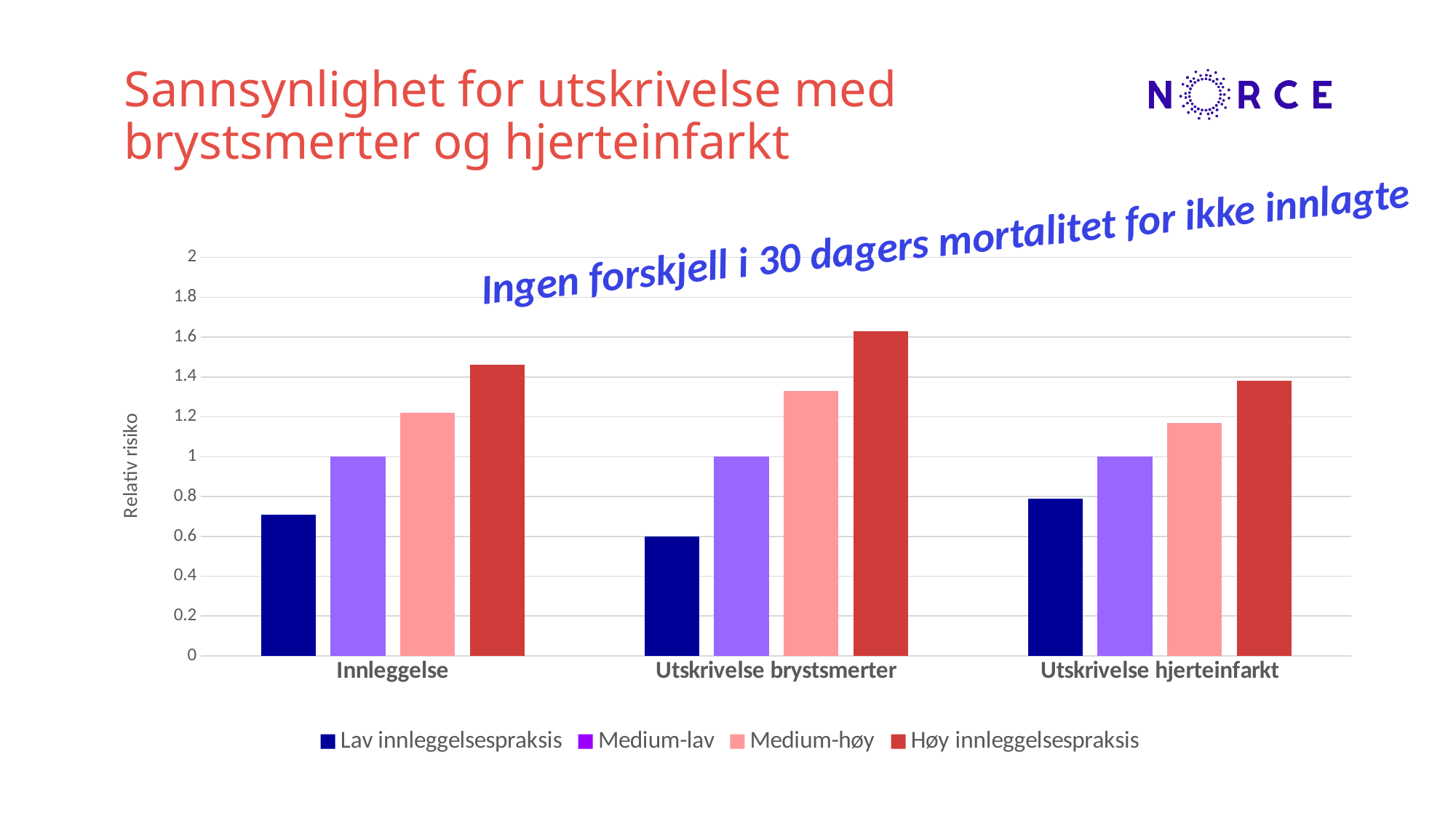
How many series does the chart legend list? 4 Which colour represents Lav innleggelsespraksis in the chart legend? dark blue Which series has the highest value in the Utskrivelse brystsmerter category? Høy innleggelsespraksis For Lav innleggelsespraksis, which category has the larger value: Utskrivelse brystsmerter or Utskrivelse hjerteinfarkt? Utskrivelse hjerteinfarkt What is the relative risk for Medium-lav in the Innleggelse category? 1 Is the value for Medium-høy in the Innleggelse category greater or less than 1.4? less Which series has the lowest value in the Innleggelse category? Lav innleggelsespraksis What is the label on the y axis of the chart? Relativ risiko What kind of chart is shown on the slide? bar chart Is the value for Høy innleggelsespraksis in the Utskrivelse brystsmerter category greater or less than 1.4? greater Is the value for Lav innleggelsespraksis in the Utskrivelse brystsmerter category greater or less than 0.8? less How many categories are shown on the x axis of the chart? 3